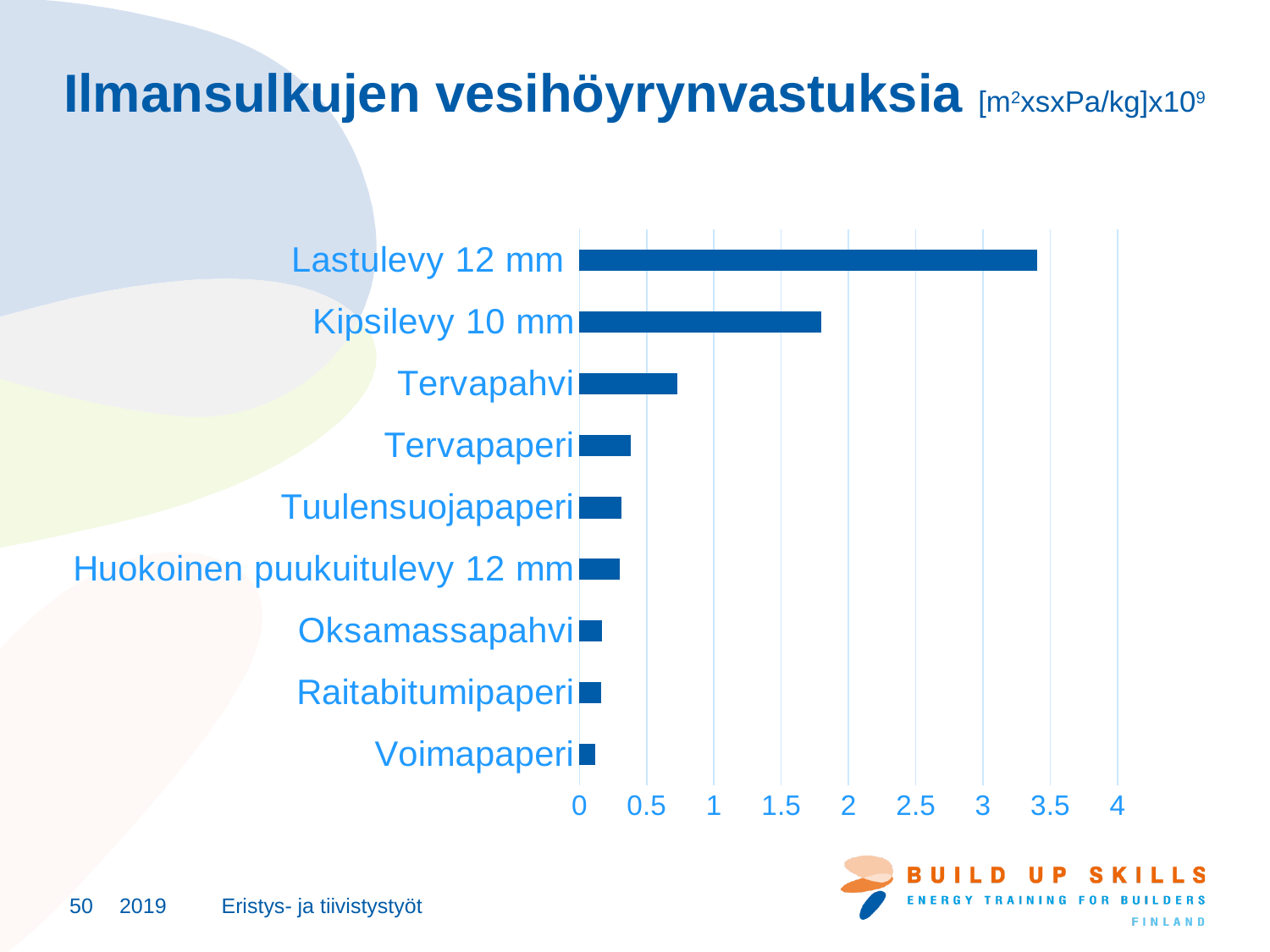
What kind of chart is shown on the slide? bar chart How many materials (categories) are shown in the chart? 9 Which material has the lowest water vapour resistance in the chart? Voimapaperi What is the title of the chart on the slide? Ilmansulkujen vesihöyrynvastuksia Which has a larger value, Kipsilevy 10 mm or Tervapahvi? Kipsilevy 10 mm Is the value for Tervapahvi greater or less than 1? less Is the value for Kipsilevy 10 mm greater or less than 2? less Do the bar values decrease from the top category to the bottom category? yes Which material has the highest water vapour resistance in the chart? Lastulevy 12 mm Is the value for Lastulevy 12 mm greater or less than 3? greater